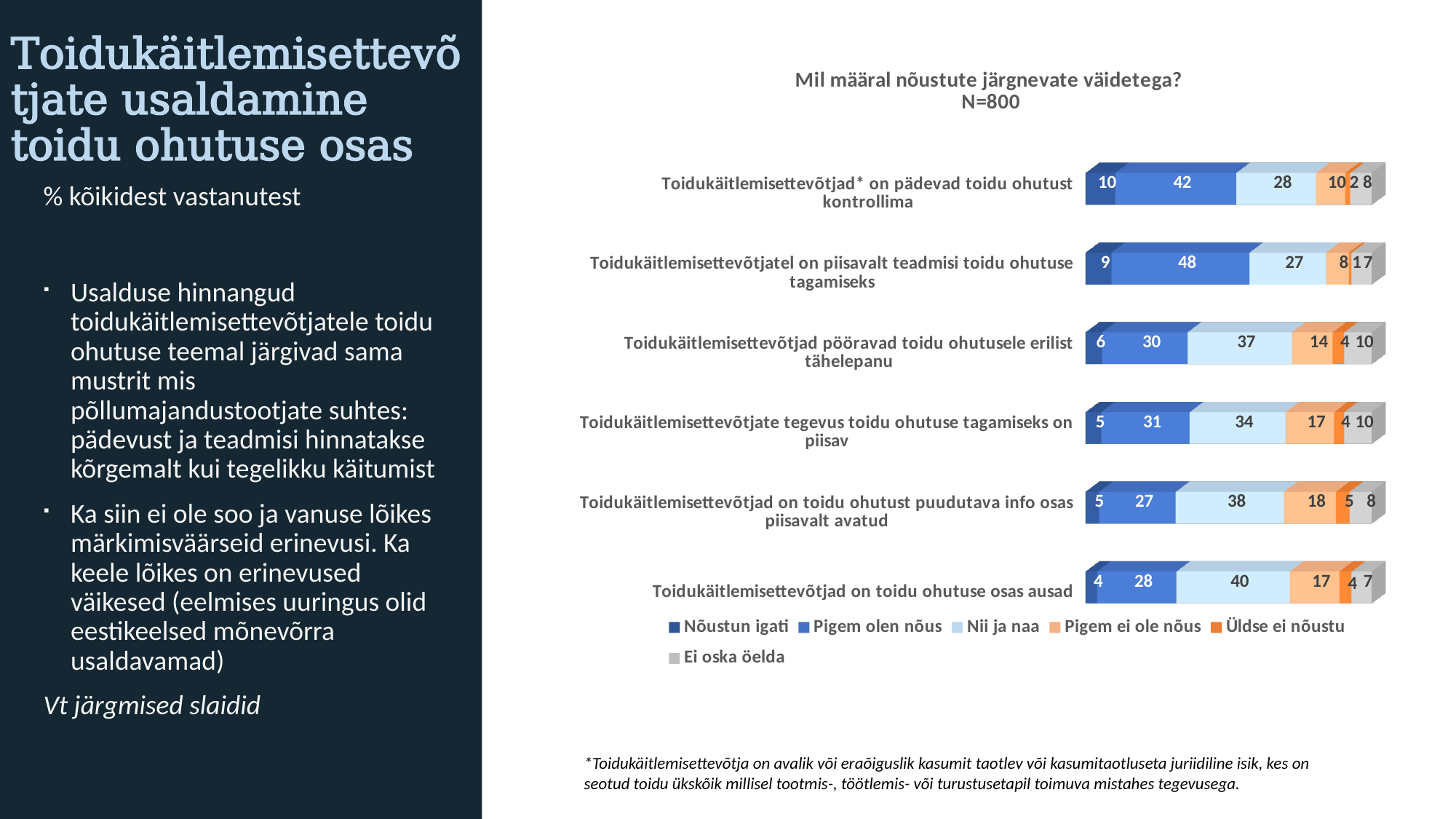
Which statement has the lowest 'Nõustun igati' value? Toidukäitlemisettevõtjad on toidu ohutuse osas ausad What is the 'Nii ja naa' value for 'Toidukäitlemisettevõtjad on toidu ohutuse osas ausad'? 40 What is the 'Pigem olen nõus' value for 'Toidukäitlemisettevõtjatel on piisavalt teadmisi toidu ohutuse tagamiseks'? 48 How many series does the chart legend list? 6 What is the sample size (N) stated in the chart title? N=800 What is the total of the stacked bar for 'Toidukäitlemisettevõtjad* on pädevad toidu ohutust kontrollima'? 100 What type of chart is shown on the slide? Stacked bar chart What is the difference between the 'Pigem olen nõus' values for 'Toidukäitlemisettevõtjatel on piisavalt teadmisi toidu ohutuse tagamiseks' and 'Toidukäitlemisettevõtjad on toidu ohutust puudutava info osas piisavalt avatud'? 21 How many statements (categories) are plotted in the chart? 6 Which is larger: the 'Nii ja naa' value for 'Toidukäitlemisettevõtjad pööravad toidu ohutusele erilist tähelepanu' or for 'Toidukäitlemisettevõtjate tegevus toidu ohutuse tagamiseks on piisav'? Toidukäitlemisettevõtjad pööravad toidu ohutusele erilist tähelepanu What is the 'Pigem ei ole nõus' value for 'Toidukäitlemisettevõtjad on toidu ohutust puudutava info osas piisavalt avatud'? 18 Which statement has the highest 'Nõustun igati' value? Toidukäitlemisettevõtjad* on pädevad toidu ohutust kontrollima